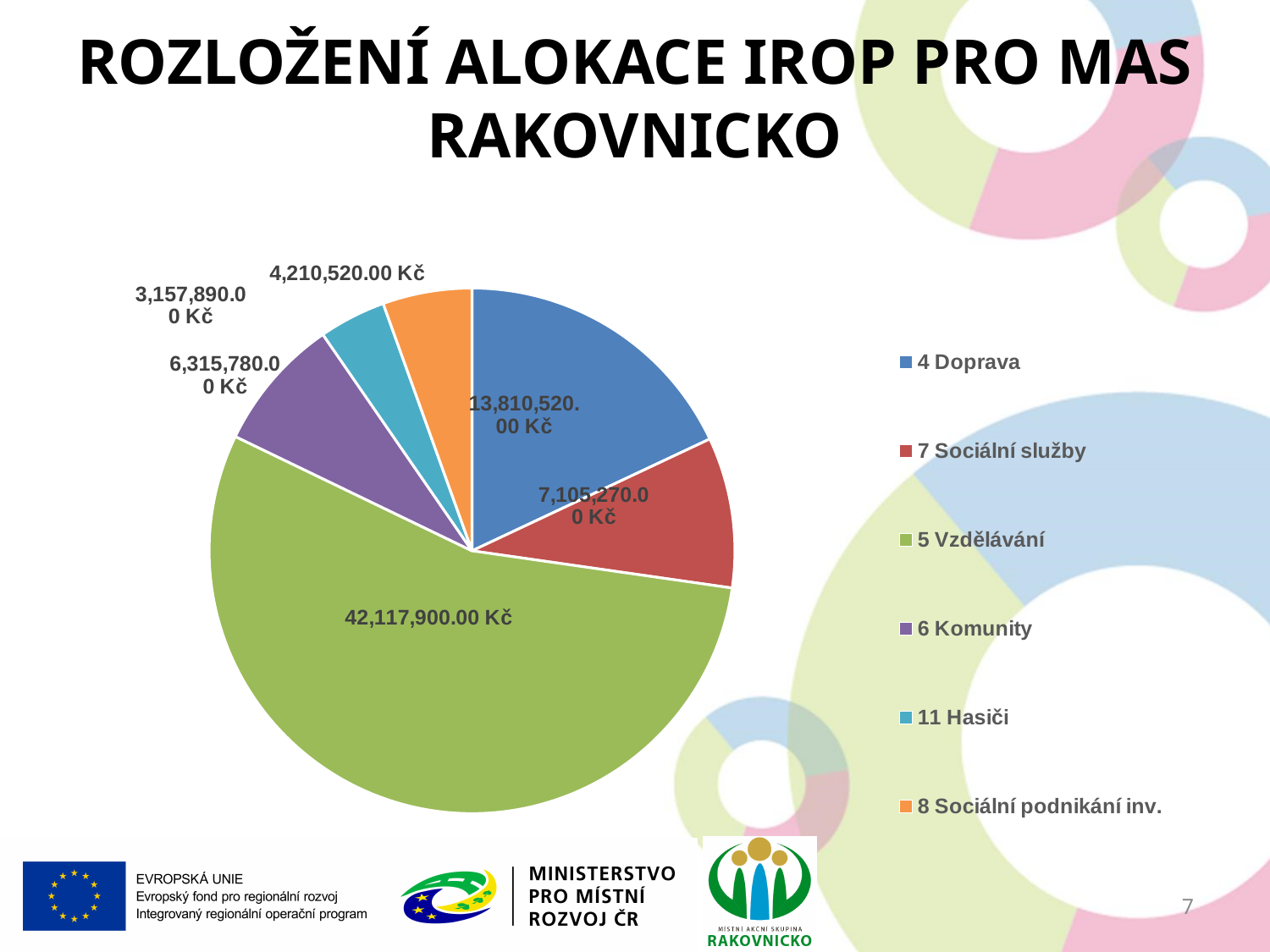
What is the difference between the values for 4 Doprava and 7 Sociální služby? 6,705,250.00 Kč Which category has the smallest slice of the pie? 11 Hasiči How many categories does the pie chart have? 6 What is the difference between the values for 6 Komunity and 11 Hasiči? 3,157,890.00 Kč Which is larger, the value for 6 Komunity or the value for 8 Sociální podnikání inv.? 6 Komunity What is the value for 5 Vzdělávání? 42,117,900.00 Kč What is the value for 8 Sociální podnikání inv.? 4,210,520.00 Kč Which category has the largest slice of the pie? 5 Vzdělávání What colour is the slice for 7 Sociální služby? red What kind of chart is shown on the slide? pie chart What is the value for 11 Hasiči? 3,157,890.00 Kč What is the value for 4 Doprava? 13,810,520.00 Kč